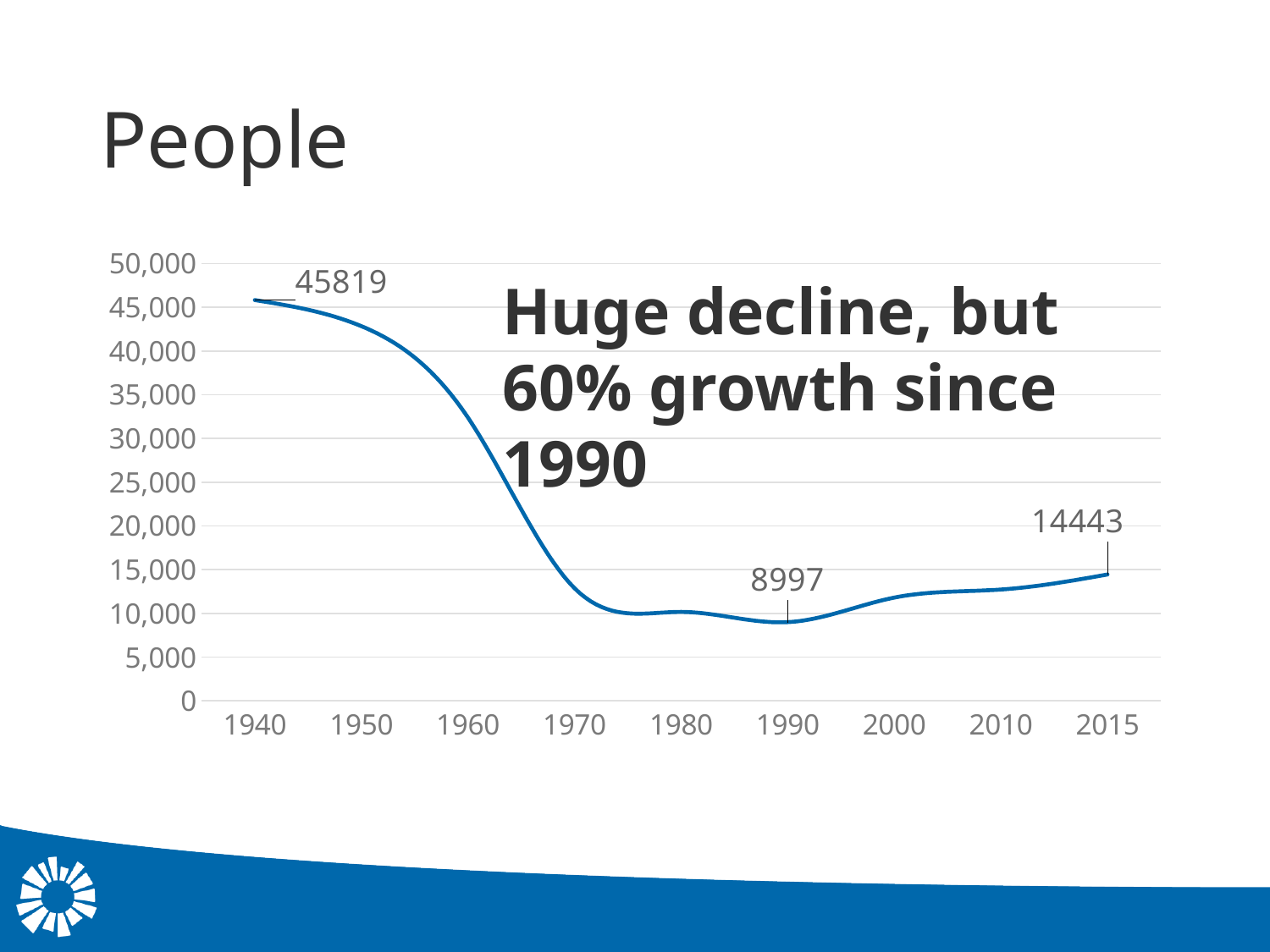
What is the value for 2015? 14443 What is the value for 1940? 45819 Is the value for 1950 greater or less than 40,000? greater Which is larger, the value for 1990 or the value for 2015? 2015 Which year has the highest value? 1940 What is the difference between the values for 2015 and 1990? 5446 How many years are labelled on the x axis? 9 What is the value for 1990? 8997 Which year has the lowest value? 1990 What is the difference between the values for 1940 and 1990? 36822 Is the value for 2010 greater or less than 15,000? less What kind of chart is shown on the slide? line chart